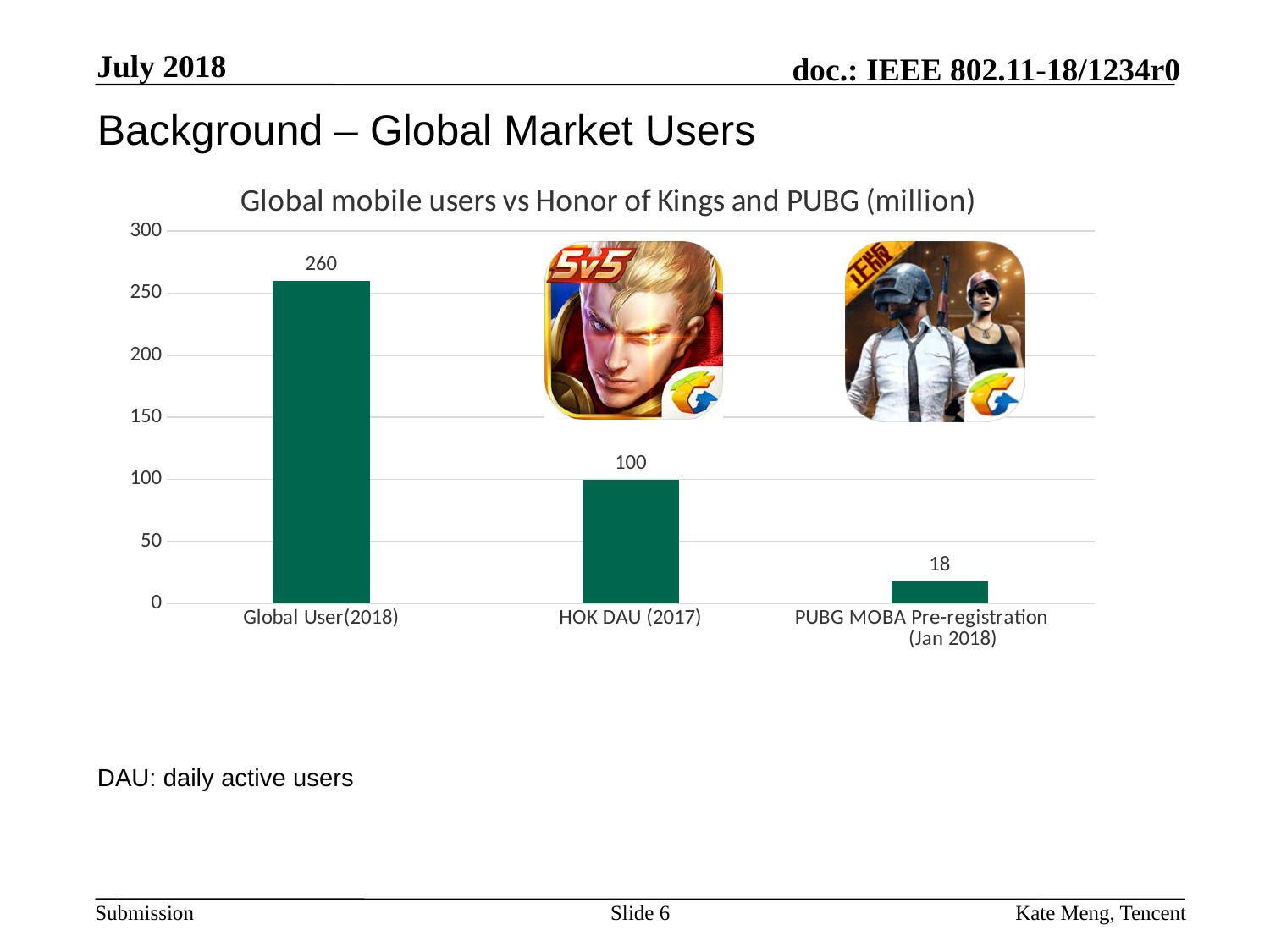
Which category has the lowest value? PUBG MOBA Pre-registration (Jan 2018) Which is larger, the value for HOK DAU (2017) or the value for PUBG MOBA Pre-registration (Jan 2018)? HOK DAU (2017) What is the value for HOK DAU (2017)? 100 Which category has the highest value? Global User(2018) What kind of chart is shown on the slide? bar chart What is the title of the chart? Global mobile users vs Honor of Kings and PUBG (million) What is the difference between the values for Global User(2018) and HOK DAU (2017)? 160 Is the value for Global User(2018) greater or less than 250? greater How many categories are shown in the chart? 3 What is the value for PUBG MOBA Pre-registration (Jan 2018)? 18 What is the difference between the values for HOK DAU (2017) and PUBG MOBA Pre-registration (Jan 2018)? 82 What is the value for Global User(2018)? 260